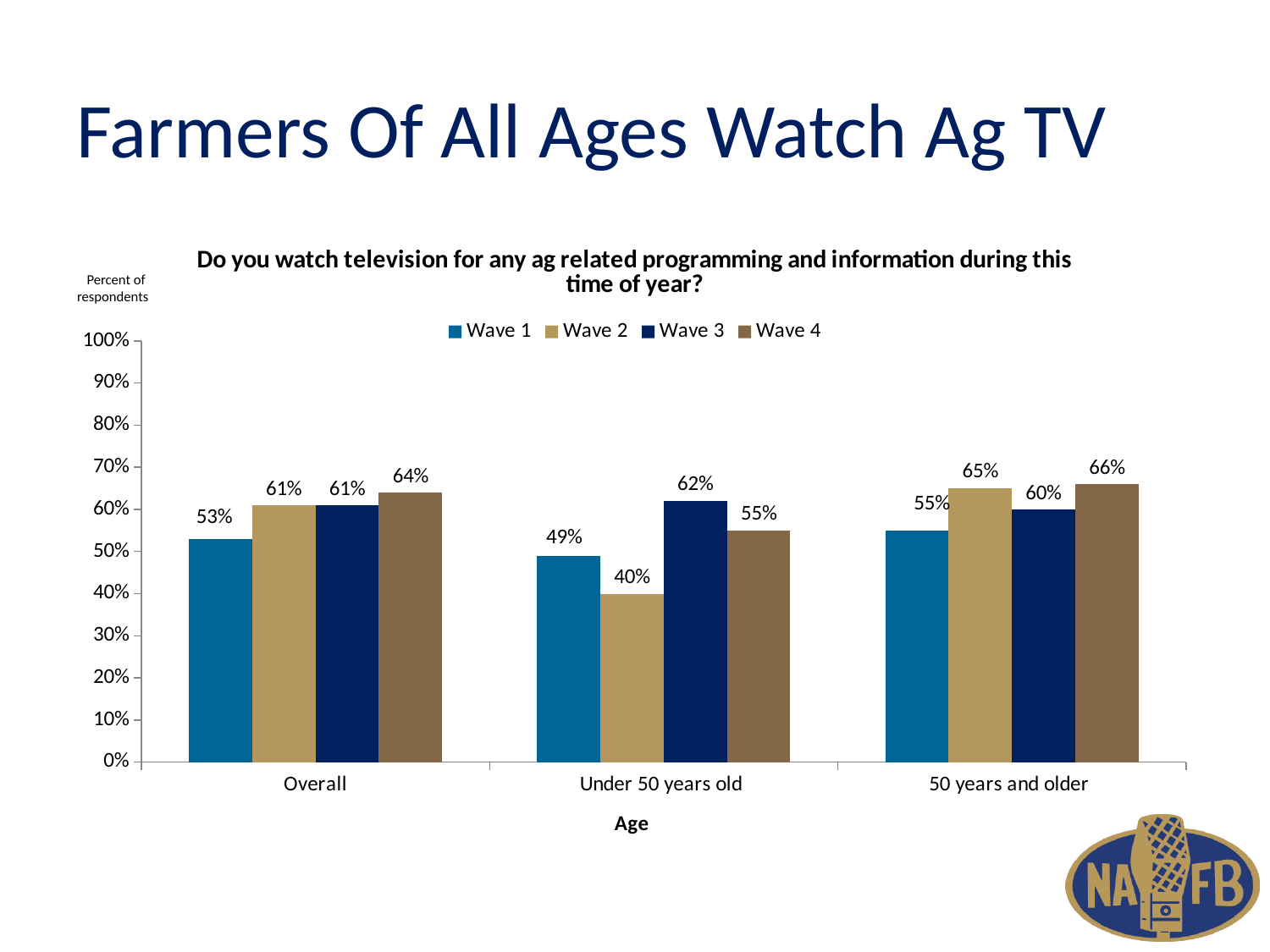
What is the Wave 1 value for Overall? 53% What is the label of the x axis? Age What kind of chart is shown on the slide? Bar chart What is the Wave 2 value for Under 50 years old? 40% Which is larger for 50 years and older: the Wave 2 value or the Wave 3 value? Wave 2 What is the Wave 3 value for Under 50 years old? 62% What is the Wave 4 value for 50 years and older? 66% How many series does the legend list? 4 What is the difference between the Wave 3 and Wave 2 values for Under 50 years old? 22% Which age category has the highest Wave 4 value? 50 years and older How many age categories are shown on the x axis? 3 Which age category has the lowest Wave 2 value? Under 50 years old